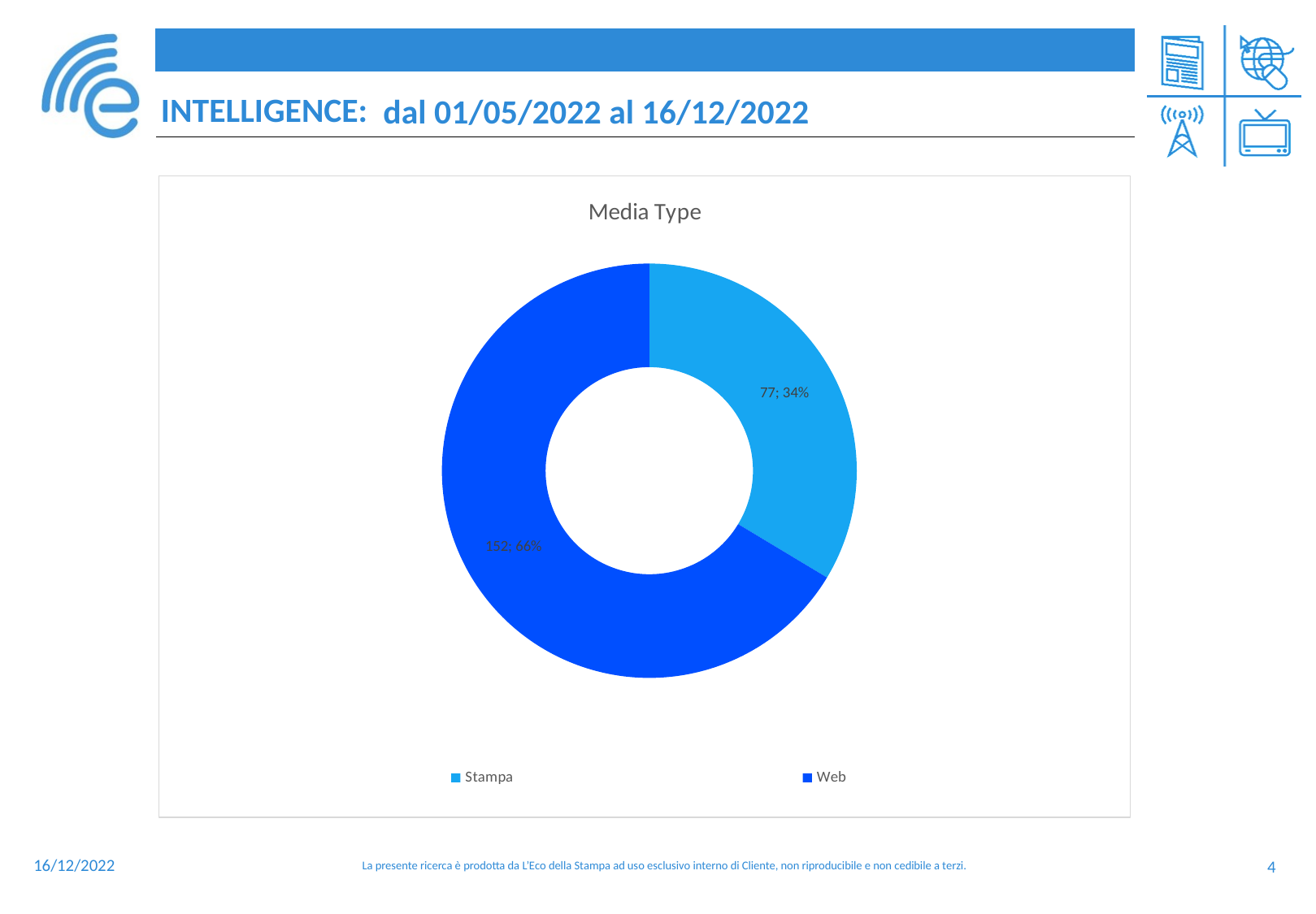
Which is larger, the value for Stampa or the value for Web? Web What is the value for Web? 152 What is the value for Stampa? 77 What share of the pie does Web represent? 66% What is the difference between the values for Web and Stampa? 75 What is the total of the two values shown in the chart? 229 Which category has the smallest slice? Stampa Which category has the largest slice? Web What share of the pie does Stampa represent? 34% How many categories does the chart show? 2 What kind of chart is shown on the slide? pie chart (doughnut) What is the title of the chart? Media Type